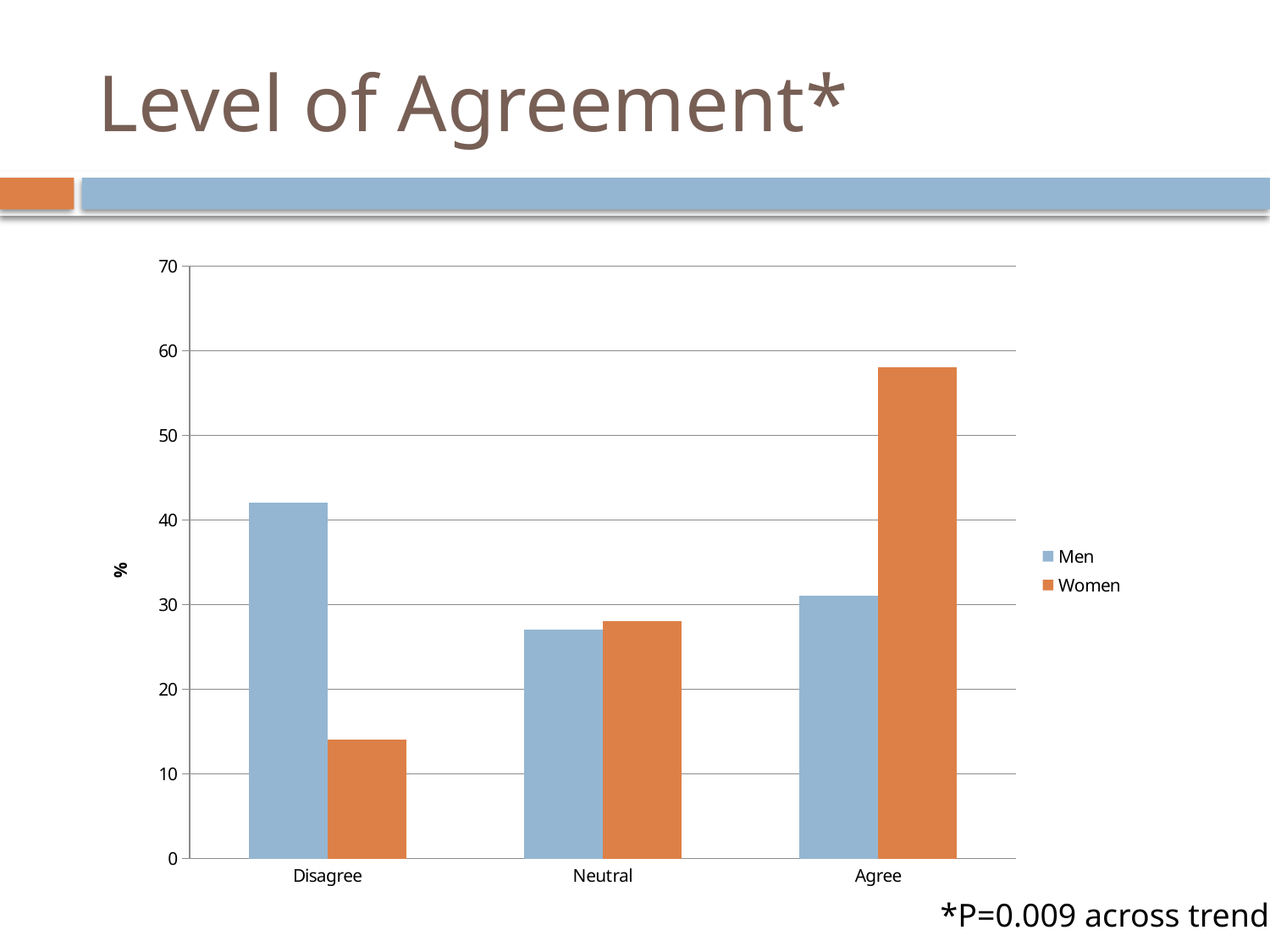
What is the title of the chart slide? Level of Agreement* Is the value for Women in the Disagree category greater or less than 20? less How many series does the legend list? 2 Is the value for Men in the Disagree category greater or less than 40? greater Which category has the highest value for Men? Disagree Which category has the highest value for Women? Agree In the Disagree category, which series has the larger value, Men or Women? Men How many categories are shown on the x axis? 3 In the Agree category, which series has the larger value, Men or Women? Women Is the value for Women in the Agree category greater or less than 50? greater What kind of chart is shown on the slide? bar chart Which category has the lowest value for Women? Disagree